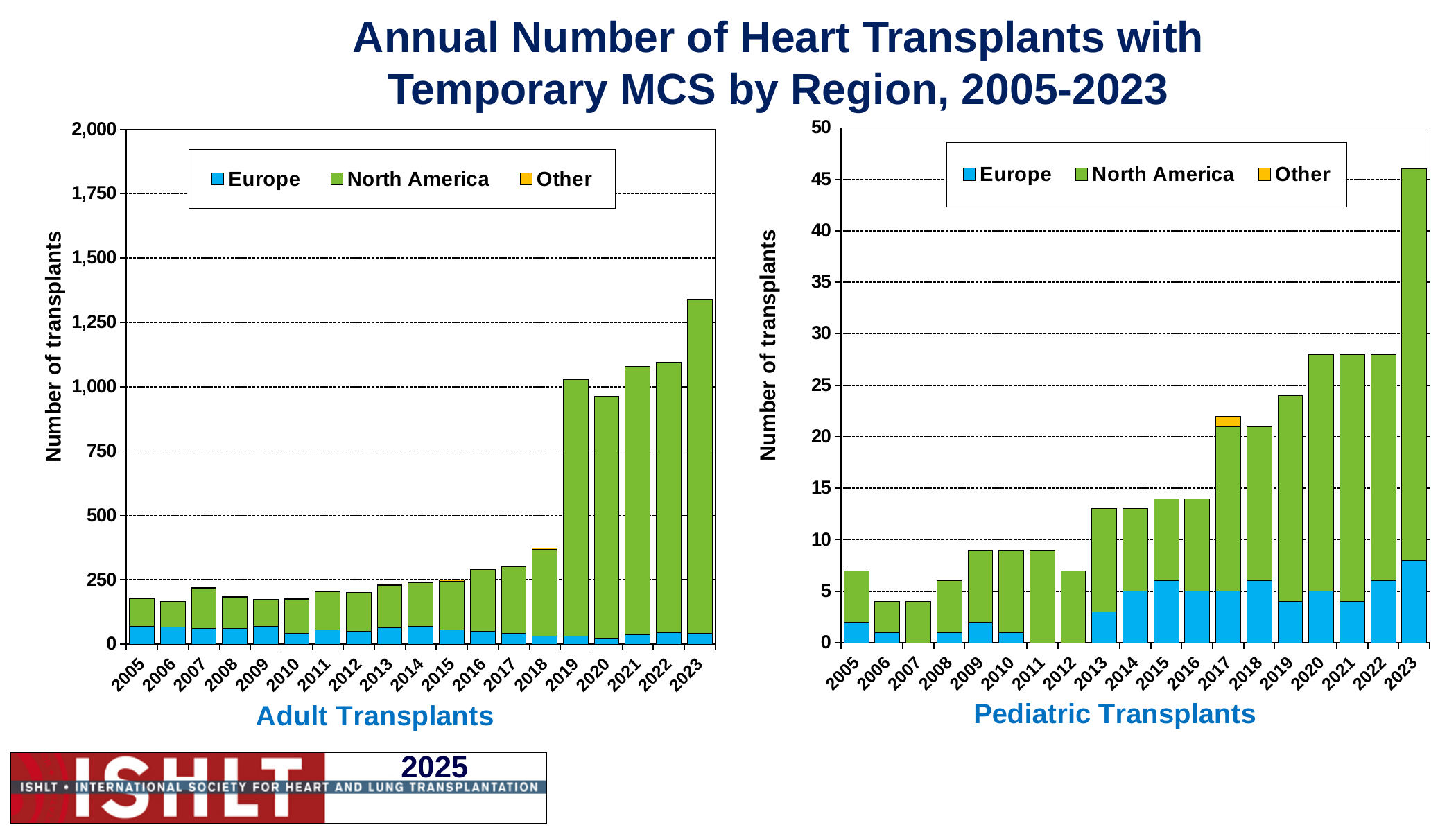
In the Adult Transplants chart, is the total for 2018 greater or less than 500? less What kind of chart is the Adult Transplants chart? bar chart How many years are shown on the x axis of the Adult Transplants chart? 19 In the Adult Transplants chart, is the total for 2023 greater or less than 1,250? greater In the Adult Transplants chart, which year has the highest total number of transplants? 2023 In the Pediatric Transplants chart, is the total for 2013 greater or less than 15? less In the Adult Transplants chart, do the totals generally rise or fall from 2005 to 2023? rise How many series does the legend of the Pediatric Transplants chart list? 3 In the Pediatric Transplants chart, which year has the highest total number of transplants? 2023 In the Adult Transplants chart, which year has the larger total, 2020 or 2021? 2021 In the Pediatric Transplants chart, what colour represents Europe? blue